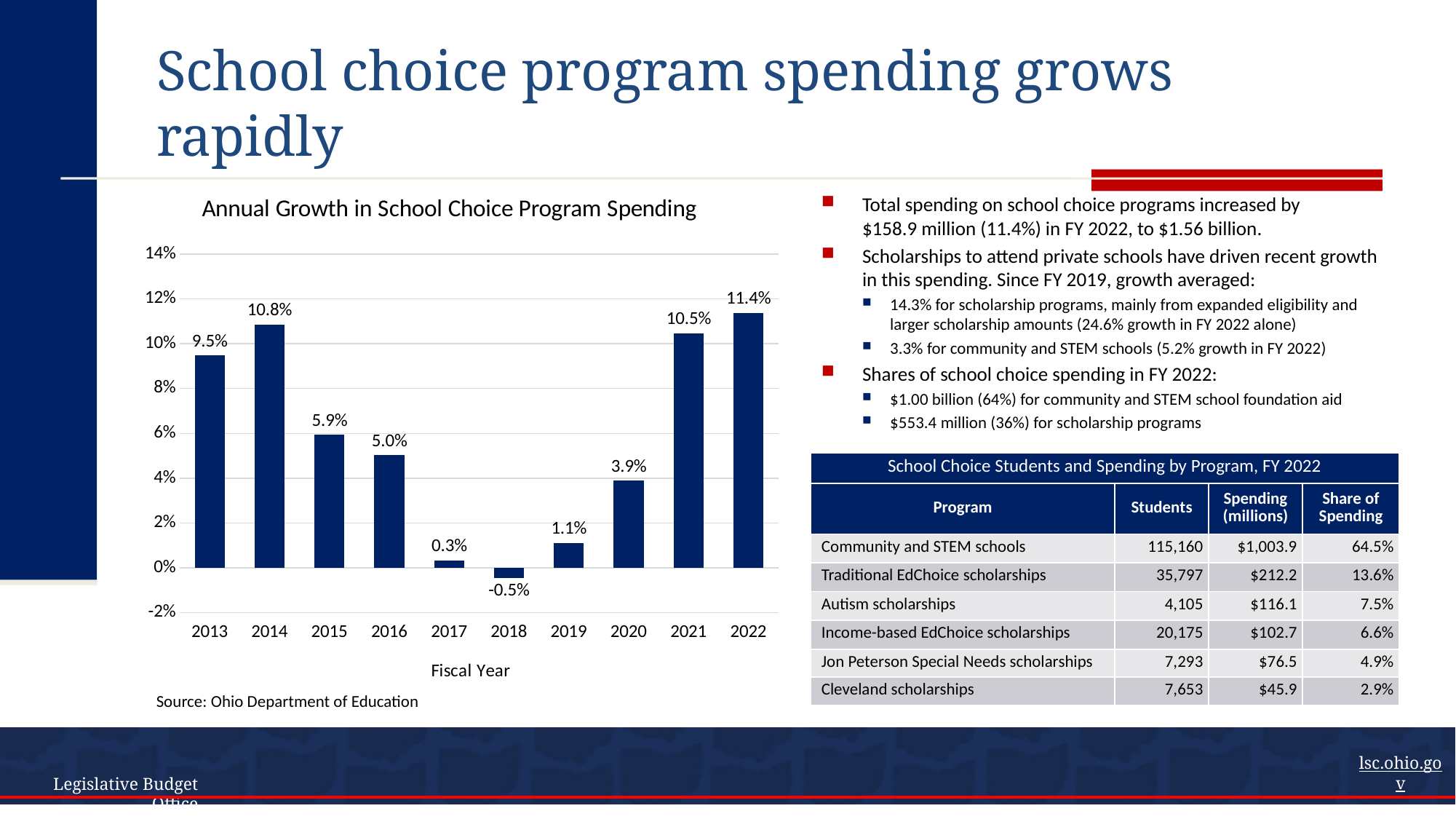
What is the annual growth in school choice program spending for fiscal year 2014? 10.8% How many fiscal years are shown in the chart? 10 What is the title of the chart? Annual Growth in School Choice Program Spending What is the annual growth in school choice program spending for fiscal year 2018? -0.5% Is the annual growth for fiscal year 2013 greater or less than 8%? greater Which fiscal year had higher annual growth, 2015 or 2016? 2015 What kind of chart is used to show annual growth in school choice program spending? Bar chart Do the annual growth values rise or fall from fiscal year 2014 to fiscal year 2017? Fall What is the annual growth in school choice program spending for fiscal year 2020? 3.9% What is the difference in annual growth between fiscal year 2022 and fiscal year 2021? 0.9% Which fiscal year has the highest annual growth in school choice program spending? 2022 Which fiscal year has the lowest annual growth in school choice program spending? 2018